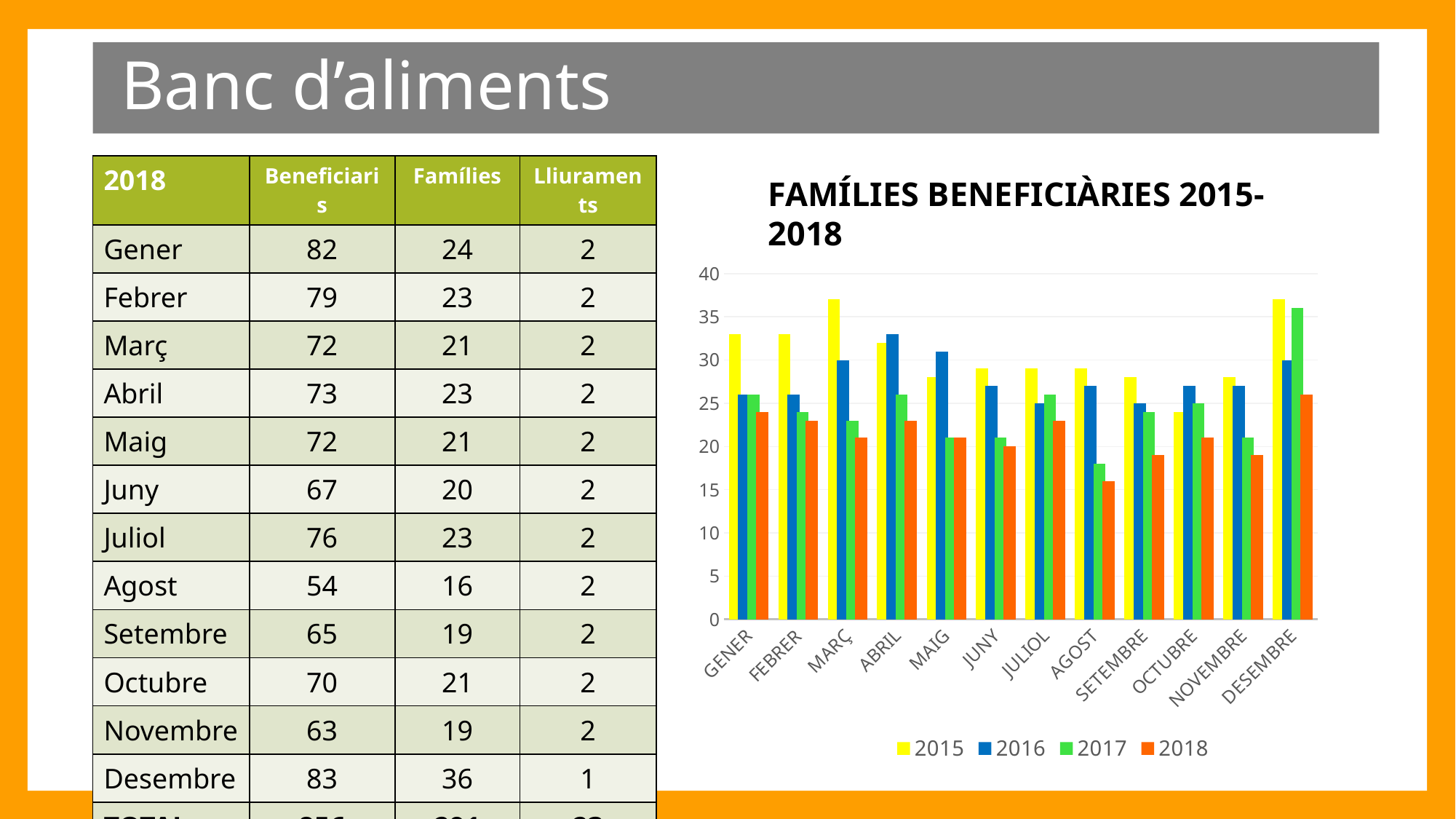
How many months are shown along the x axis of the chart? 12 What is the title of the chart? FAMÍLIES BENEFICIÀRIES 2015-2018 In the chart, which month has the lowest value for 2018? AGOST Is the 2018 value for AGOST greater or less than 20? less What kind of chart is shown on the slide? bar chart Which colour represents the 2018 series in the chart? orange In the chart, for GENER, which is larger: the 2015 value or the 2018 value? 2015 Is the 2015 value for MARÇ greater or less than 35? greater In the chart, which month has the lowest value for 2017? AGOST In the chart, which month has the highest value for 2018? DESEMBRE In the chart, for DESEMBRE, which is larger: the 2016 value or the 2017 value? 2017 How many series does the chart legend list? 4